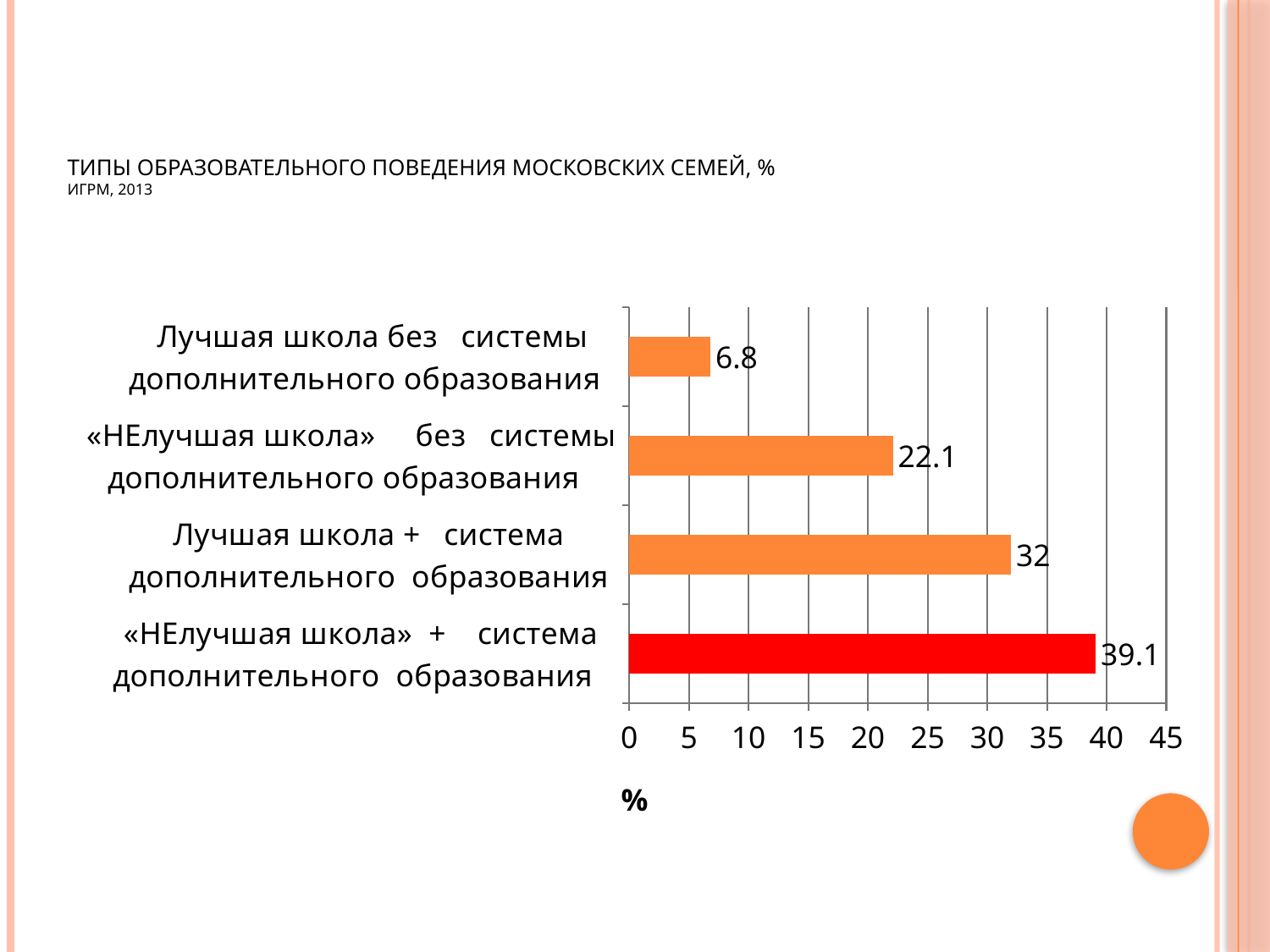
What is the difference between the values for «НЕлучшая школа» + система дополнительного образования and Лучшая школа + система дополнительного образования? 7.1 Which is larger: the value for Лучшая школа + система дополнительного образования or the value for «НЕлучшая школа» без системы дополнительного образования? Лучшая школа + система дополнительного образования What kind of chart is shown on the slide? Bar chart Which category has the highest value? «НЕлучшая школа» + система дополнительного образования How many categories are shown in the chart? 4 What is the difference between the values for «НЕлучшая школа» без системы дополнительного образования and Лучшая школа без системы дополнительного образования? 15.3 Which bar is coloured red rather than orange? «НЕлучшая школа» + система дополнительного образования What is the value for «НЕлучшая школа» + система дополнительного образования? 39.1 What is the value for Лучшая школа + система дополнительного образования? 32 What is the value for Лучшая школа без системы дополнительного образования? 6.8 What is the value for «НЕлучшая школа» без системы дополнительного образования? 22.1 Which category has the lowest value? Лучшая школа без системы дополнительного образования